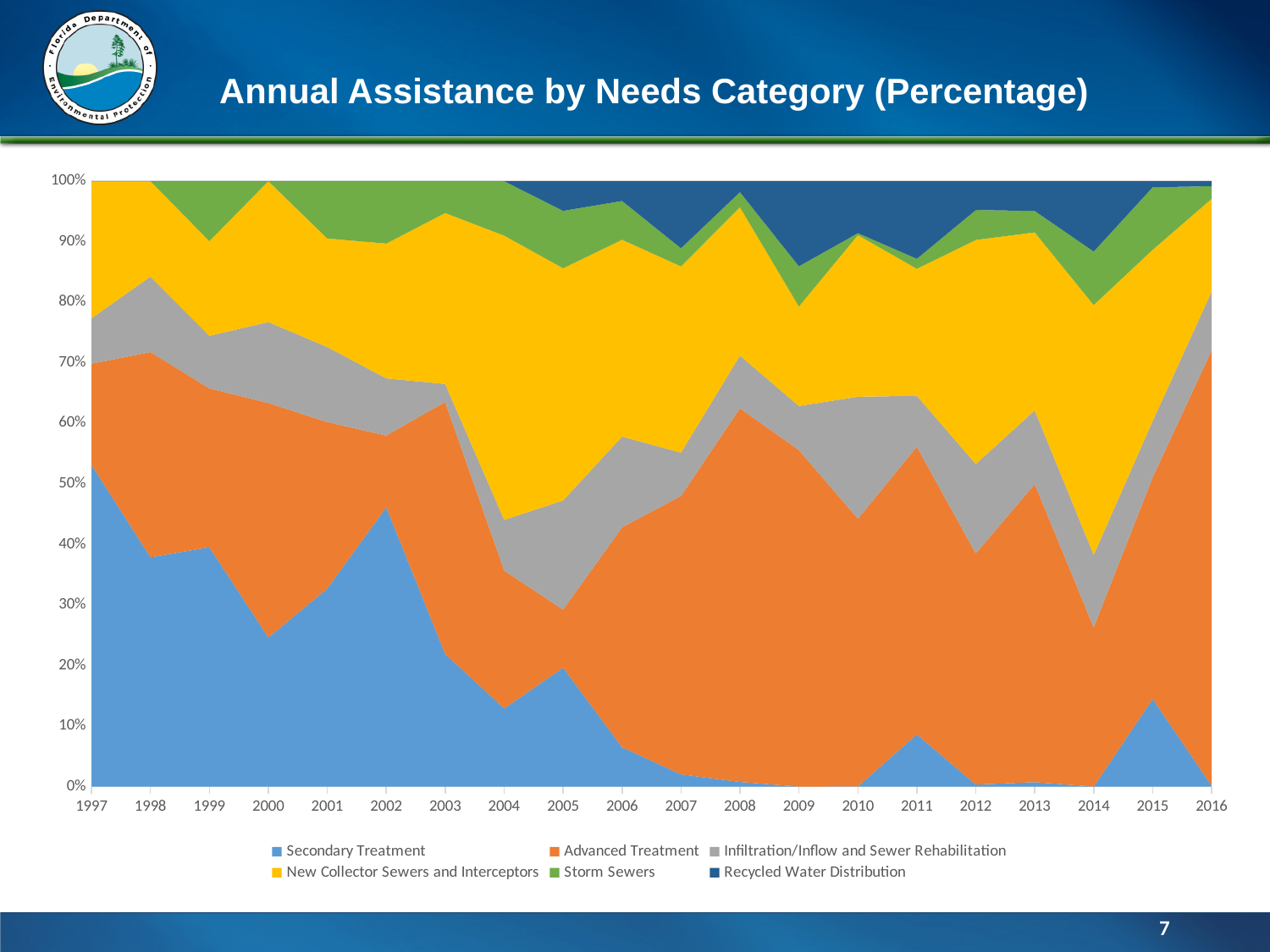
In which year is the Secondary Treatment share highest? 1997 How many series does the legend list? 6 Is the value for Secondary Treatment in 1997 greater or less than 50%? greater Is the value for Secondary Treatment in 2015 greater or less than 10%? greater How many years are plotted along the x axis? 20 Which colour represents Advanced Treatment in the chart? Orange Is the value for Secondary Treatment in 2002 greater or less than 50%? less What is the title of the chart? Annual Assistance by Needs Category (Percentage) What kind of chart is shown on the slide? Stacked area chart Does the Secondary Treatment share generally rise or fall from 1997 to 2007? Fall